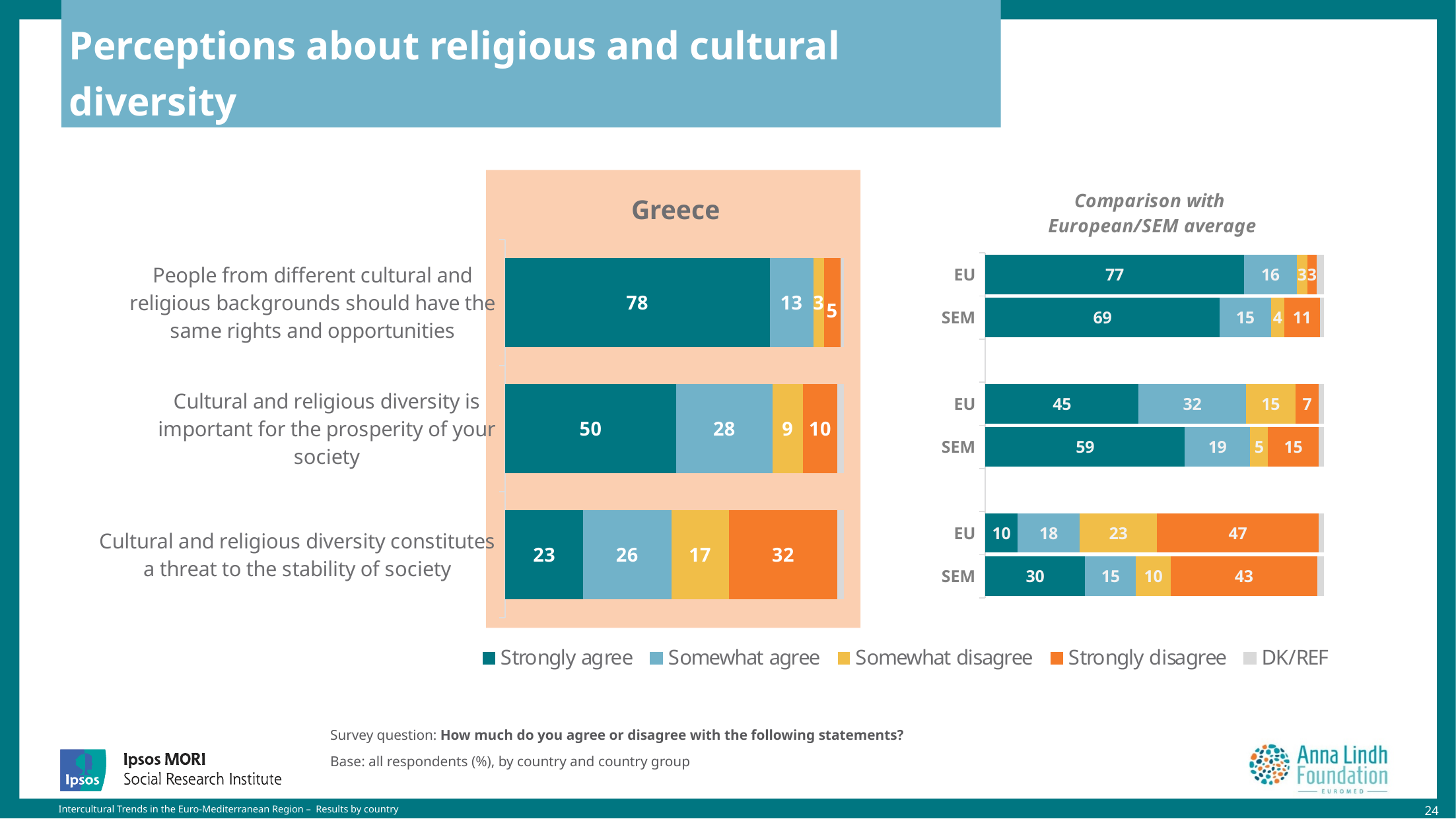
In the Comparison with European/SEM average chart, what is the SEM value for Strongly disagree on the statement that cultural and religious diversity constitutes a threat to the stability of society? 43 In the Comparison with European/SEM average chart, what is the difference between the EU and SEM Strongly disagree values for the statement that diversity constitutes a threat to the stability of society? 4 In the Greece chart, what percentage strongly disagree that cultural and religious diversity constitutes a threat to the stability of society? 32 In the Greece chart, which statement has the highest Strongly agree value? People from different cultural and religious backgrounds should have the same rights and opportunities How many statements are shown in the Greece chart? 3 In the Greece chart, what is the difference between the Strongly agree values for the 'same rights and opportunities' statement and the 'prosperity of your society' statement? 28 What is the title of the chart on the right side of the slide? Comparison with European/SEM average What kind of chart is the Greece chart? Bar chart How many series does the legend list? 5 In the Comparison with European/SEM average chart, for the statement that diversity constitutes a threat to the stability of society, which has the larger Strongly agree value, EU or SEM? SEM In the Comparison with European/SEM average chart, what is the EU value for Strongly agree on the statement that cultural and religious diversity is important for the prosperity of your society? 45 In the Greece chart, what percentage strongly agree that people from different cultural and religious backgrounds should have the same rights and opportunities? 78